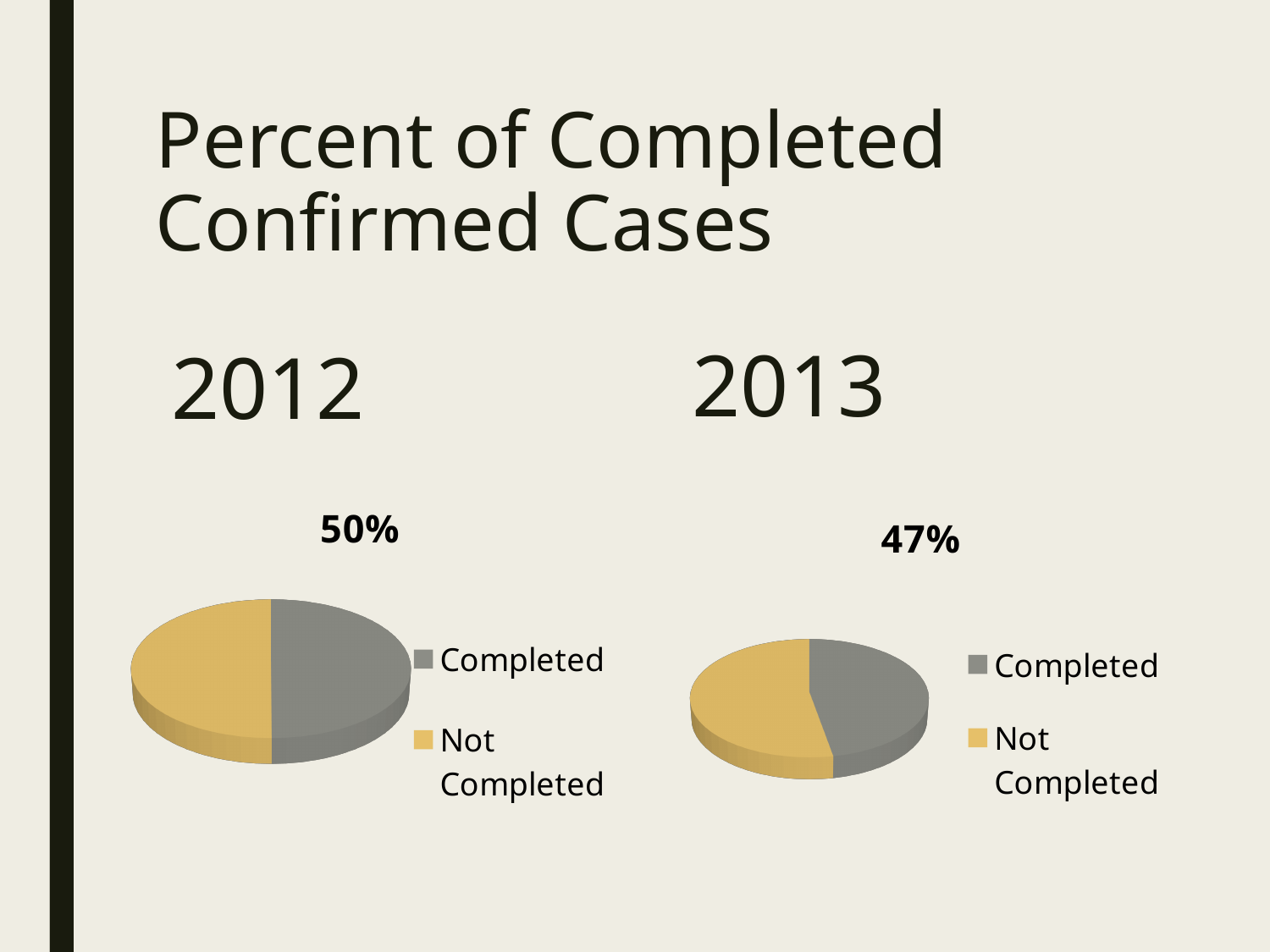
In the 2013 chart, what percent of confirmed cases were completed? 47% Which year shows the higher percent of completed confirmed cases, 2012 or 2013? 2012 What colour represents the Completed slice in the 2013 chart? grey What type of chart is used for the 2013 data? pie chart How many slices does the 2013 pie chart have? 2 What type of chart is used for the 2012 data? pie chart How many slices does the 2012 pie chart have? 2 What are the two legend entries in the 2012 chart? Completed, Not Completed In the 2012 chart, what percent of confirmed cases were completed? 50% How many entries does the legend of the 2012 chart list? 2 What is the difference between the completed percentages shown for 2012 and 2013? 3% In the 2013 chart, which slice is larger, Completed or Not Completed? Not Completed